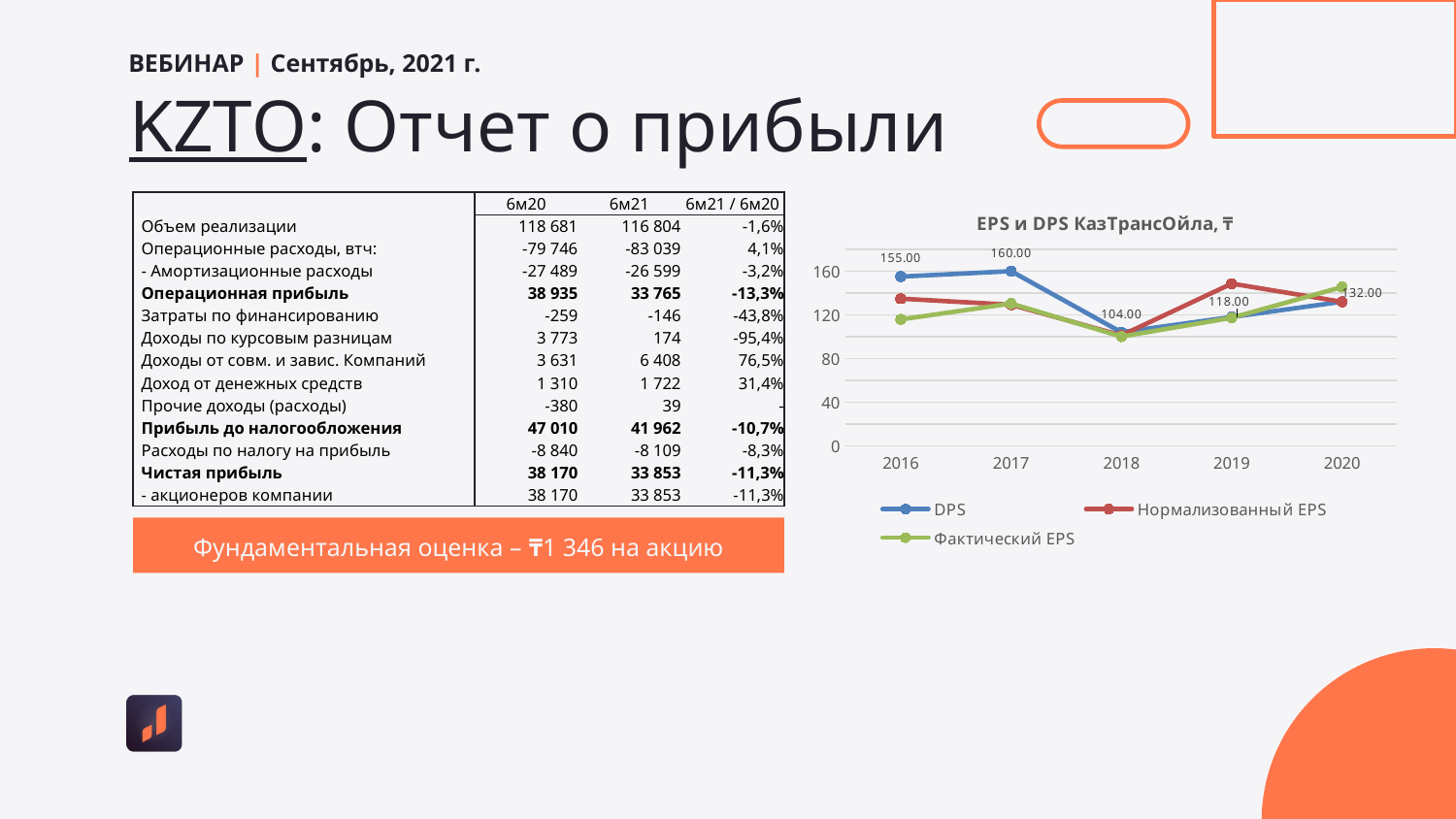
In which year is DPS lowest? 2018 Is the value for Нормализованный EPS in 2016 greater or less than 120? greater What kind of chart is shown on the slide? Line chart Is the value for Фактический EPS in 2018 greater or less than 120? less What is the DPS value for 2017 in the chart? 160.00 How many series does the chart legend list? 3 Which is larger, the DPS value for 2016 or for 2019? 2016 What is the DPS value for 2018 in the chart? 104.00 How many years are shown on the x axis of the chart? 5 What is the DPS value for 2020 in the chart? 132.00 In which year is DPS highest? 2017 What is the difference between the DPS values for 2017 and 2018? 56.00